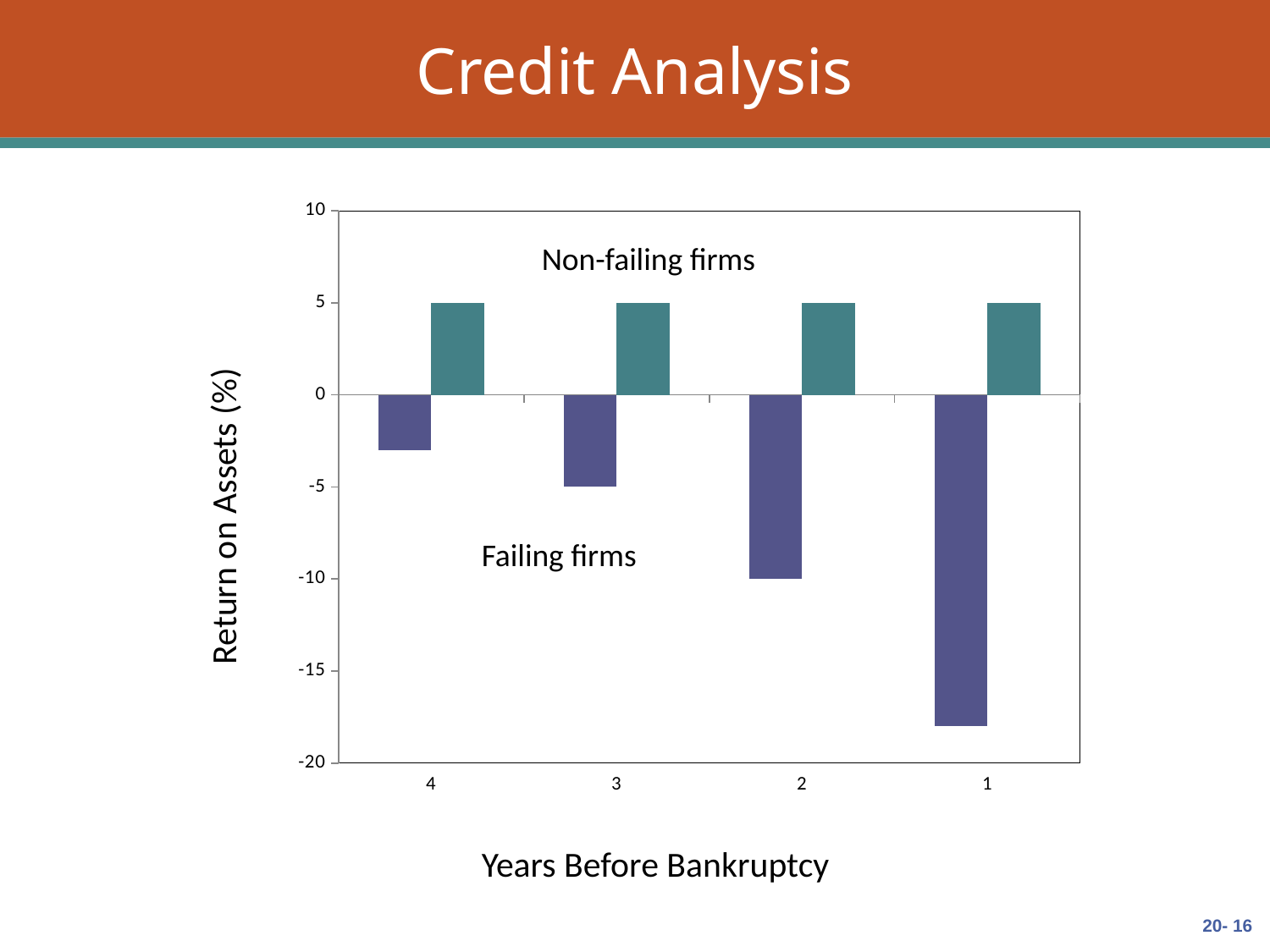
What is the Return on Assets (%) for Failing firms at 2 years before bankruptcy? -10 What kind of chart is shown on the slide? bar chart Do the values for Failing firms rise or fall as the x axis moves from 4 years to 1 year before bankruptcy? fall Is the value for Failing firms at 1 year before bankruptcy greater or less than -15? less At which number of years before bankruptcy is the Return on Assets for Failing firms lowest? 1 What is the label of the vertical axis? Return on Assets (%) Is the value for Failing firms at 4 years before bankruptcy greater or less than -5? greater How many categories are shown on the x axis (Years Before Bankruptcy)? 4 What is the Return on Assets (%) for Non-failing firms at 4 years before bankruptcy? 5 Which is larger: the Failing firms value at 3 years or at 2 years before bankruptcy? 3 years What is the difference between the Non-failing firms value and the Failing firms value at 3 years before bankruptcy? 10 What is the Return on Assets (%) for Failing firms at 3 years before bankruptcy? -5